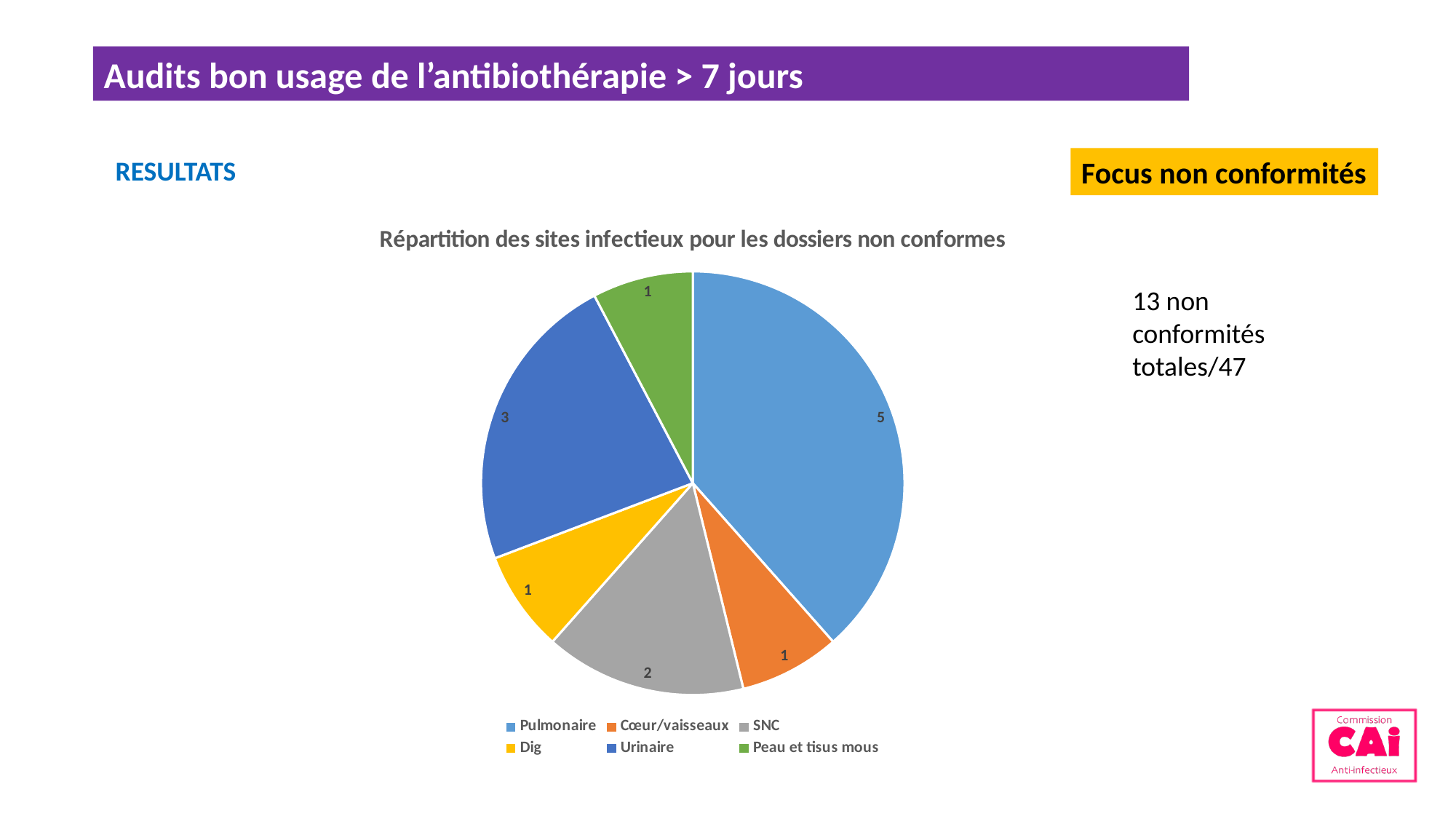
What is the title of the chart? Répartition des sites infectieux pour les dossiers non conformes What is the value for Urinaire? 3 Which colour represents Peau et tisus mous in the legend? Green Which category has the largest slice of the pie? Pulmonaire What is the value for SNC? 2 Which is larger, the value for SNC or the value for Dig? SNC How many categories does the pie chart show? 6 What is the difference between the values for Pulmonaire and Urinaire? 2 What is the total of all the slices in the pie chart? 13 What type of chart is shown on the slide? Pie chart What is the value for Cœur/vaisseaux? 1 What is the value for Pulmonaire? 5